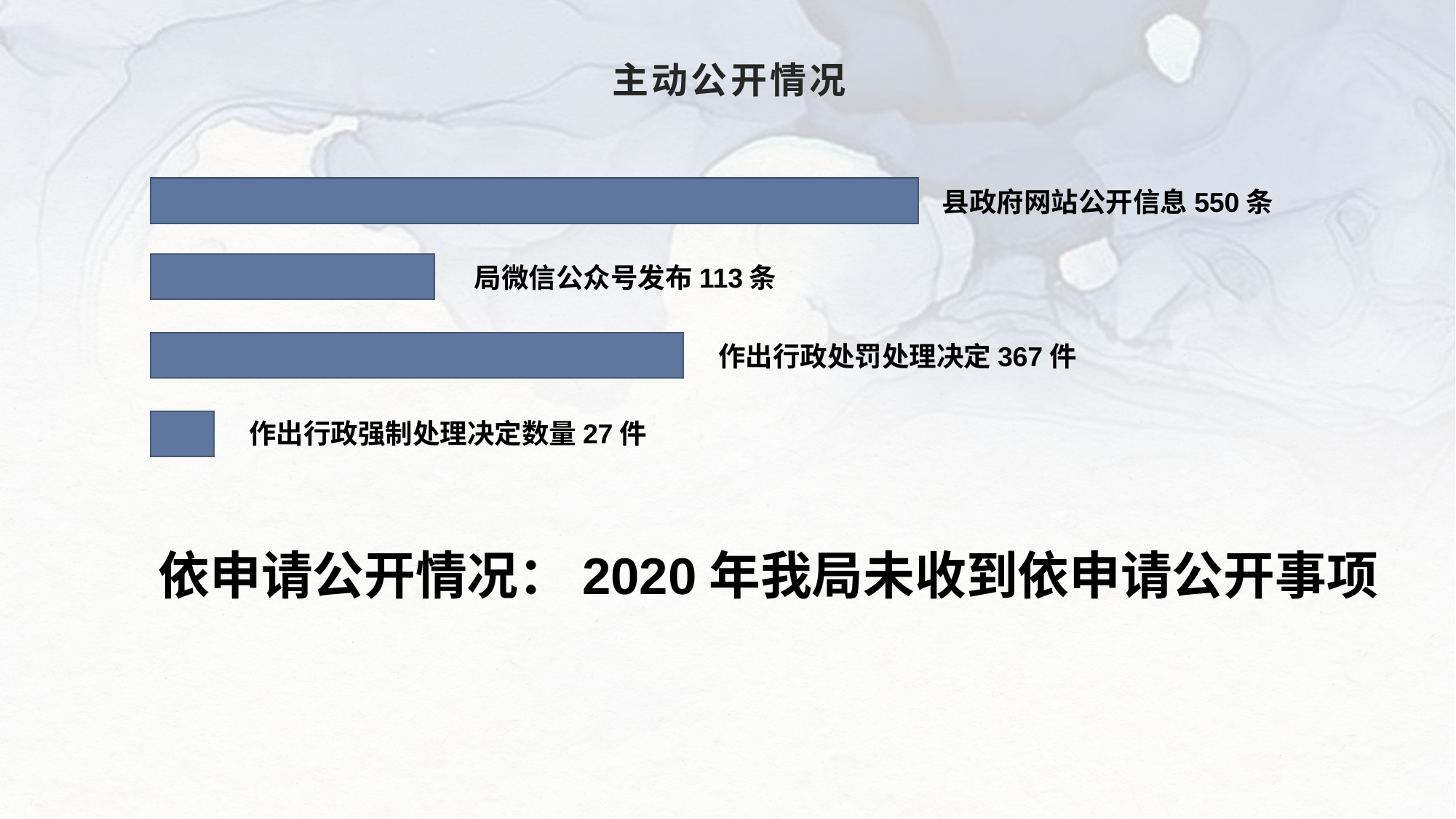
Which category has the highest value? 县政府网站公开信息 Which category has the lowest value? 作出行政强制处理决定数量 Which is larger, the value for 作出行政处罚处理决定 or the value for 局微信公众号发布? 作出行政处罚处理决定 What is the value for 局微信公众号发布? 113 条 What is the value for 县政府网站公开信息? 550 条 What is the value for 作出行政处罚处理决定? 367 件 How many bars does the chart have? 4 What is the title of the chart on the slide? 主动公开情况 What is the difference between the values for 作出行政处罚处理决定 and 作出行政强制处理决定数量? 340 What is the difference between the values for 县政府网站公开信息 and 局微信公众号发布? 437 What kind of chart is shown on the slide? bar chart What is the value for 作出行政强制处理决定数量? 27 件